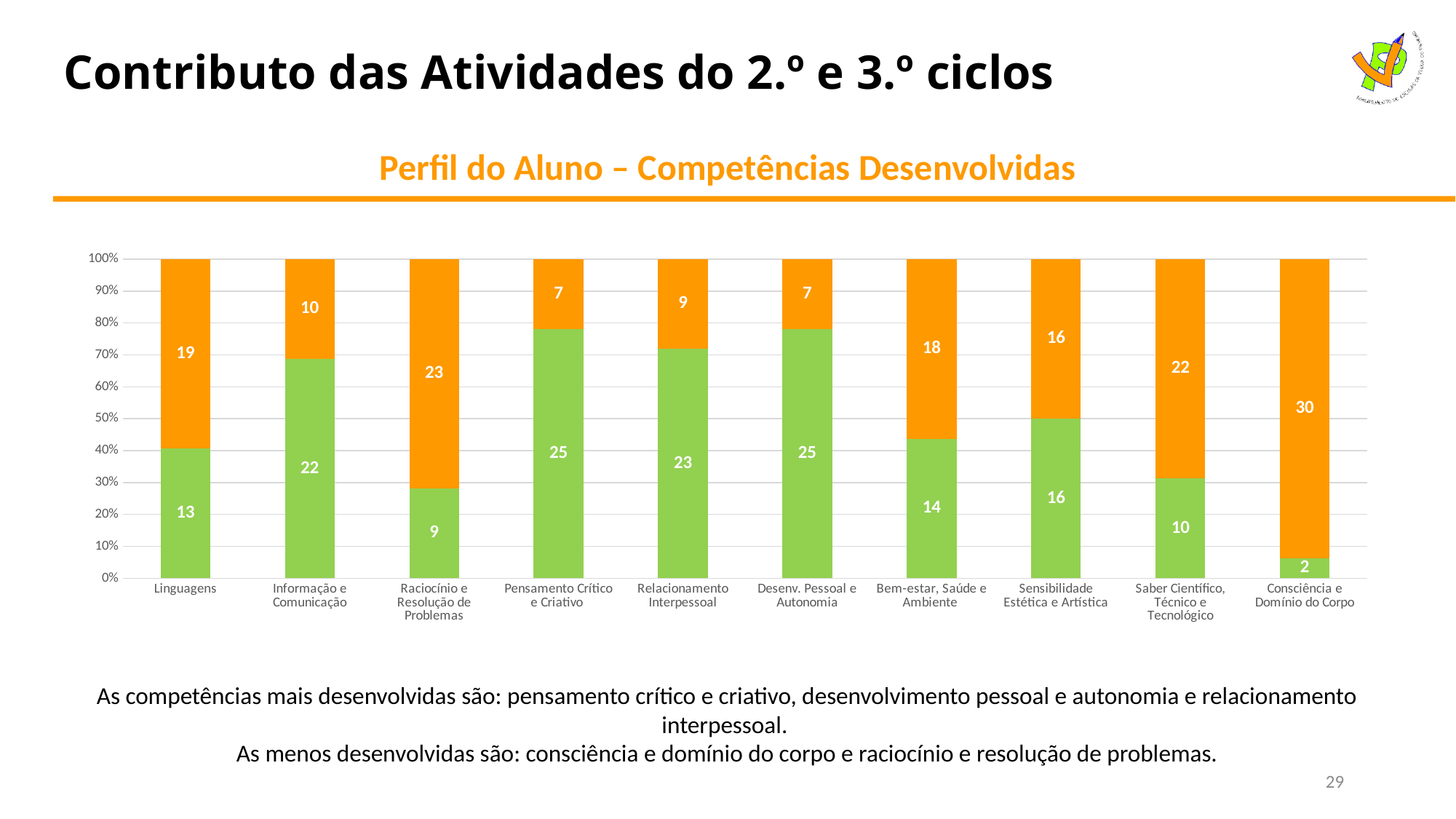
What is the value of the green segment for Linguagens? 13 What is the value of the orange segment for Consciência e Domínio do Corpo? 30 Which category has the lowest green segment value? Consciência e Domínio do Corpo What is the difference between the orange segment values for Consciência e Domínio do Corpo and Pensamento Crítico e Criativo? 23 Which is larger: the green segment for Informação e Comunicação or the green segment for Bem-estar, Saúde e Ambiente? Informação e Comunicação What is the total of the green and orange segments for Linguagens? 32 Which category has the highest green segment value? Pensamento Crítico e Criativo and Desenv. Pessoal e Autonomia (25) What is the value of the orange segment for Saber Científico, Técnico e Tecnológico? 22 What is the title shown above the chart? Perfil do Aluno – Competências Desenvolvidas Is the top of the green segment for Consciência e Domínio do Corpo greater or less than 10%? less What kind of chart is shown on the slide? Stacked bar chart How many categories are shown on the x axis? 10